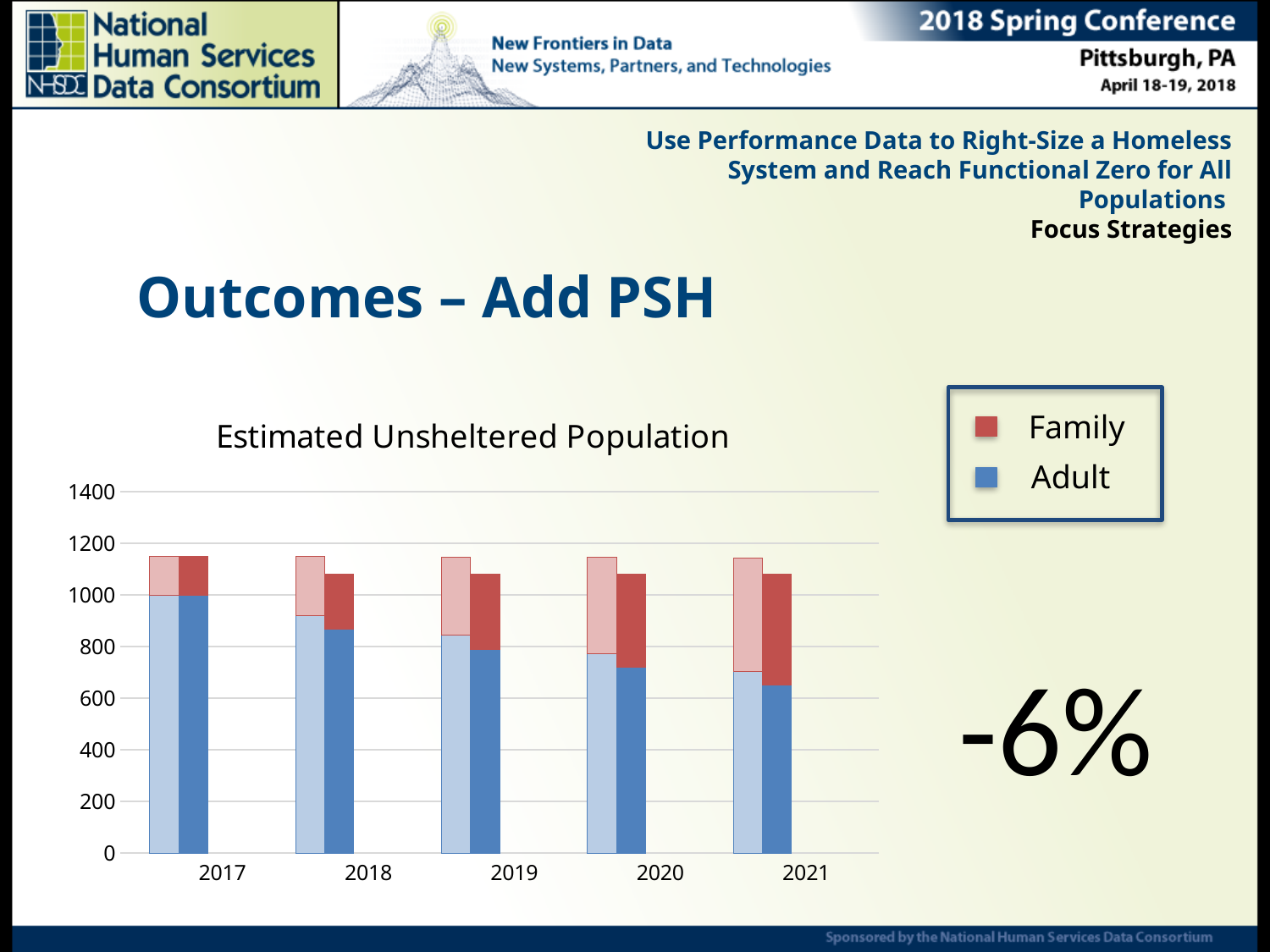
What kind of chart is shown on the slide? Stacked bar chart In which year is the Adult value lowest? 2021 Is the Adult value for 2021 (darker bar) greater or less than 800? less In which year is the Adult value highest? 2017 How many years are shown along the x axis of the chart? 5 What is the title of the chart? Estimated Unsheltered Population Is the total stacked height of the 2017 bar greater or less than 1200? less Is the Adult value for 2018 (darker bar) greater or less than 800? greater Which is larger, the Adult value for 2017 or the Adult value for 2021? 2017 Which colour represents the Family series in the legend? Red Does the Adult portion of the bars rise or fall from 2017 to 2021? Fall How many series does the legend list? 2